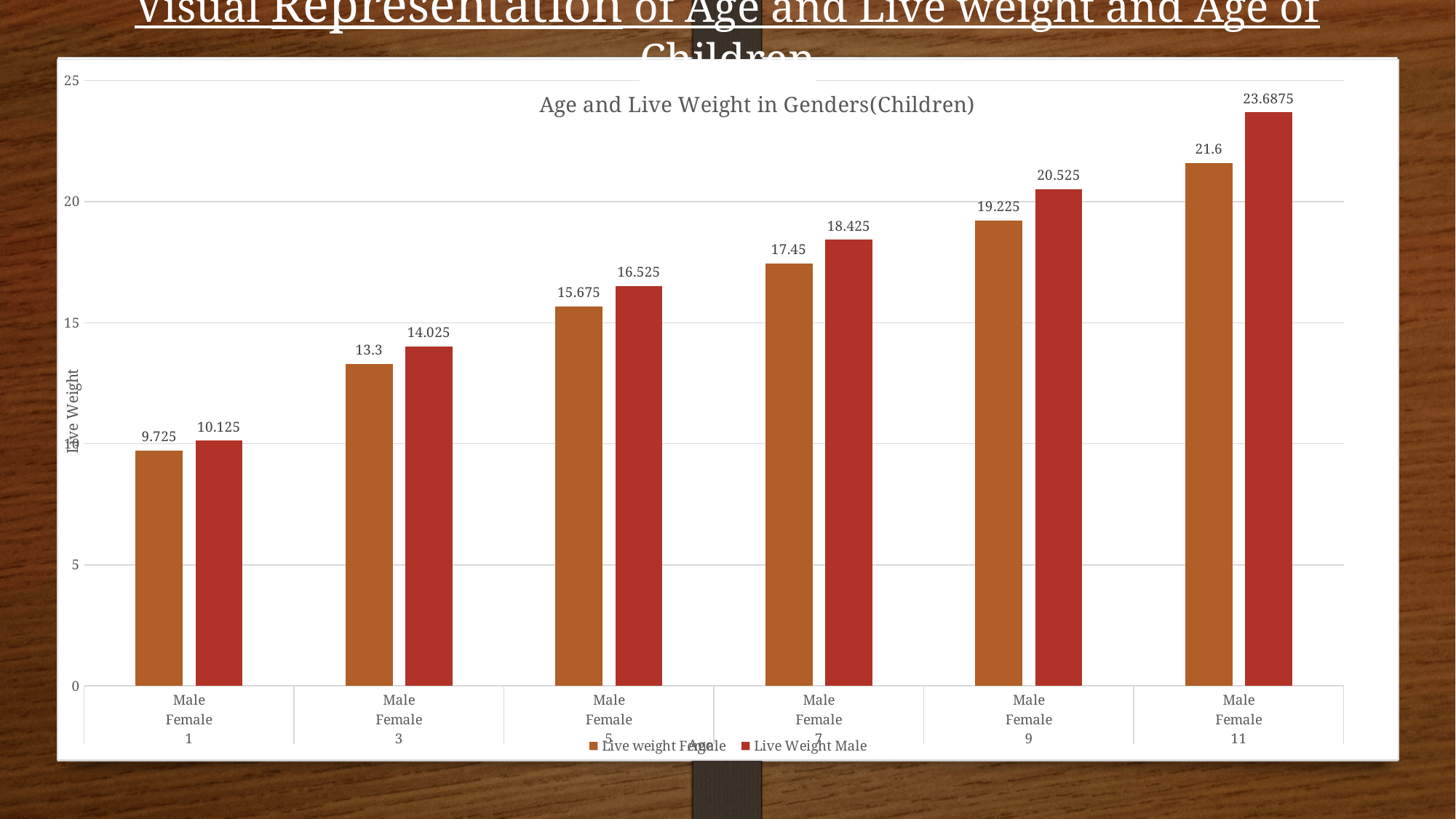
What is the Live Weight Male value at age 5? 16.525 How many age categories are shown on the x axis? 6 How many series does the legend list? 2 What is the Live Weight Male value at age 11? 23.6875 What is the Live weight Female value at age 1? 9.725 At which age is the Live weight Female value highest? 11 What kind of chart is shown on the slide? Bar chart At which age is the Live Weight Male value lowest? 1 At age 7, which is larger: Live weight Female or Live Weight Male? Live Weight Male What is the Live weight Female value at age 9? 19.225 What is the difference between the Live Weight Male and Live weight Female values at age 3? 0.725 Do the Live Weight Male values rise or fall as age increases along the x axis? Rise